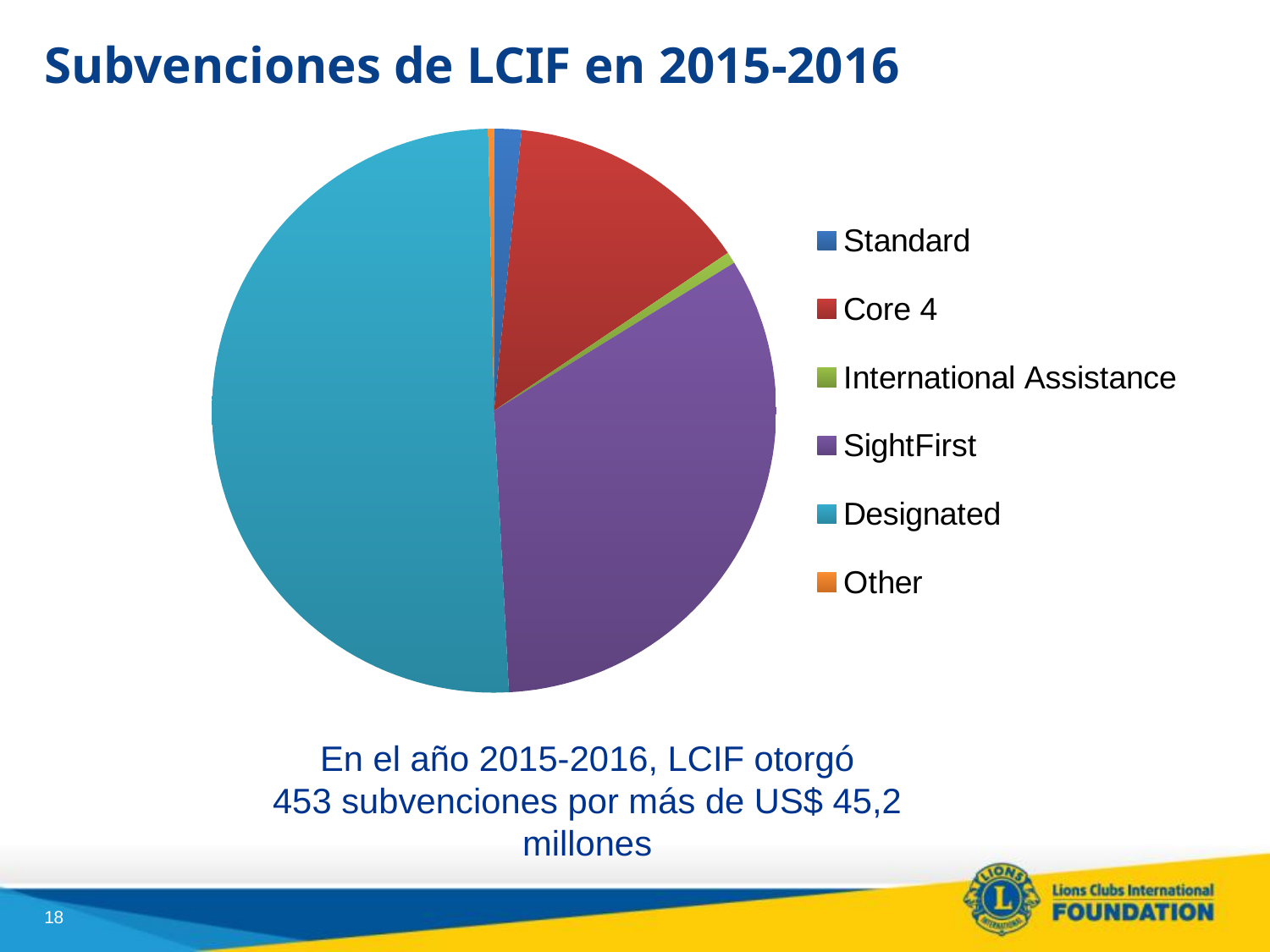
How many slices does the pie chart have? 6 What is the title of the slide containing the pie chart? Subvenciones de LCIF en 2015-2016 Which slice is larger, Standard or International Assistance? Standard Which slice is larger, Standard or Core 4? Core 4 Which slice is larger, SightFirst or Core 4? SightFirst What kind of chart is shown on the slide? pie chart What colour is the Designated slice in the pie chart? teal How many entries does the legend of the pie chart list? 6 Which category has the largest slice of the pie chart? Designated